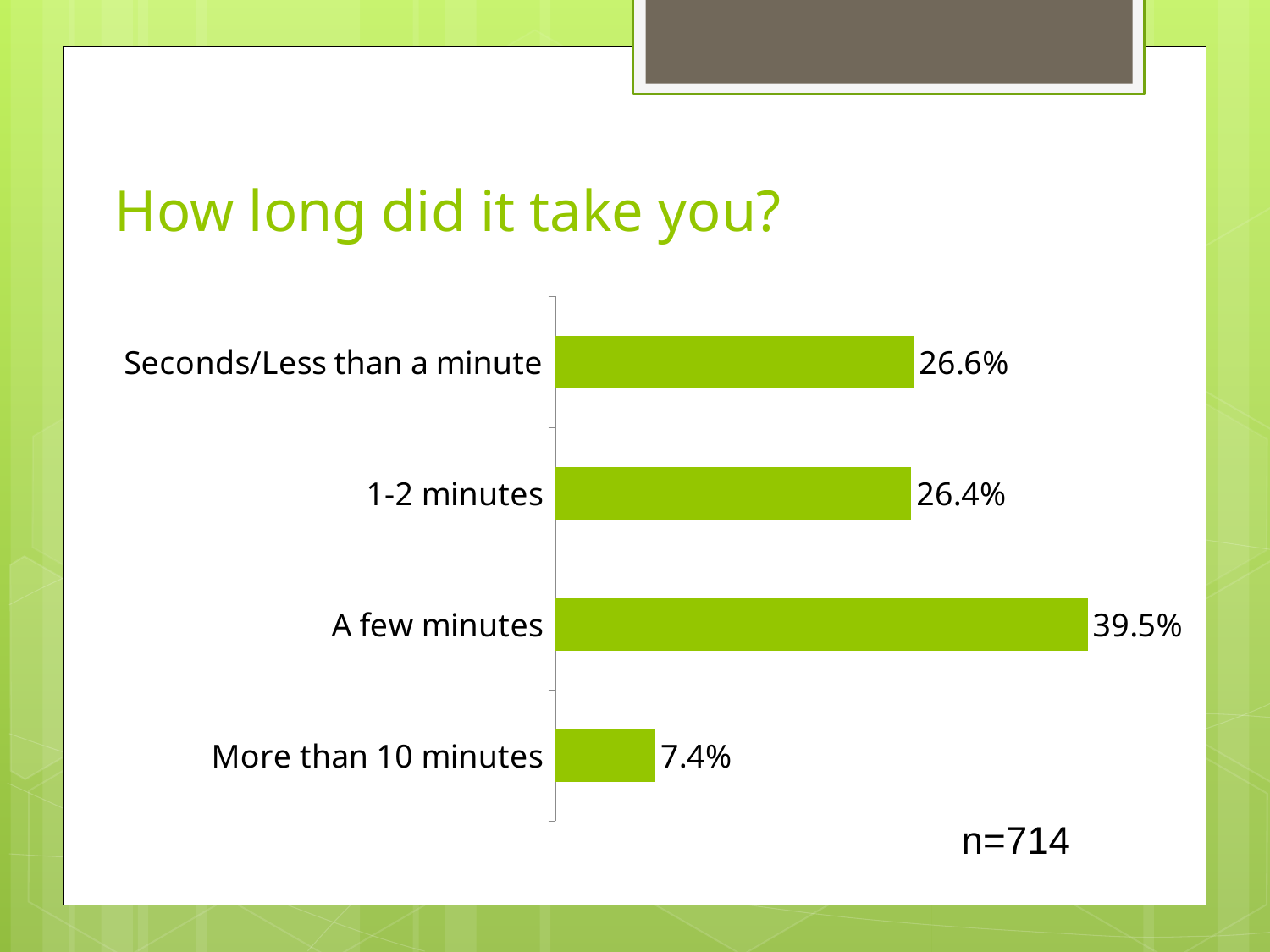
What sample size (n) is shown on the slide? n=714 Which category has the highest value? A few minutes What is the difference between the values for "A few minutes" and "More than 10 minutes"? 32.1% Which category has the lowest value? More than 10 minutes What is the value for "A few minutes"? 39.5% How many categories are shown in the chart? 4 What is the value for "1-2 minutes"? 26.4% What is the value for "More than 10 minutes"? 7.4% What kind of chart is shown on the slide? Bar chart What is the difference between the values for "Seconds/Less than a minute" and "1-2 minutes"? 0.2% Which is larger, the value for "A few minutes" or the value for "1-2 minutes"? A few minutes What is the value for "Seconds/Less than a minute"? 26.6%